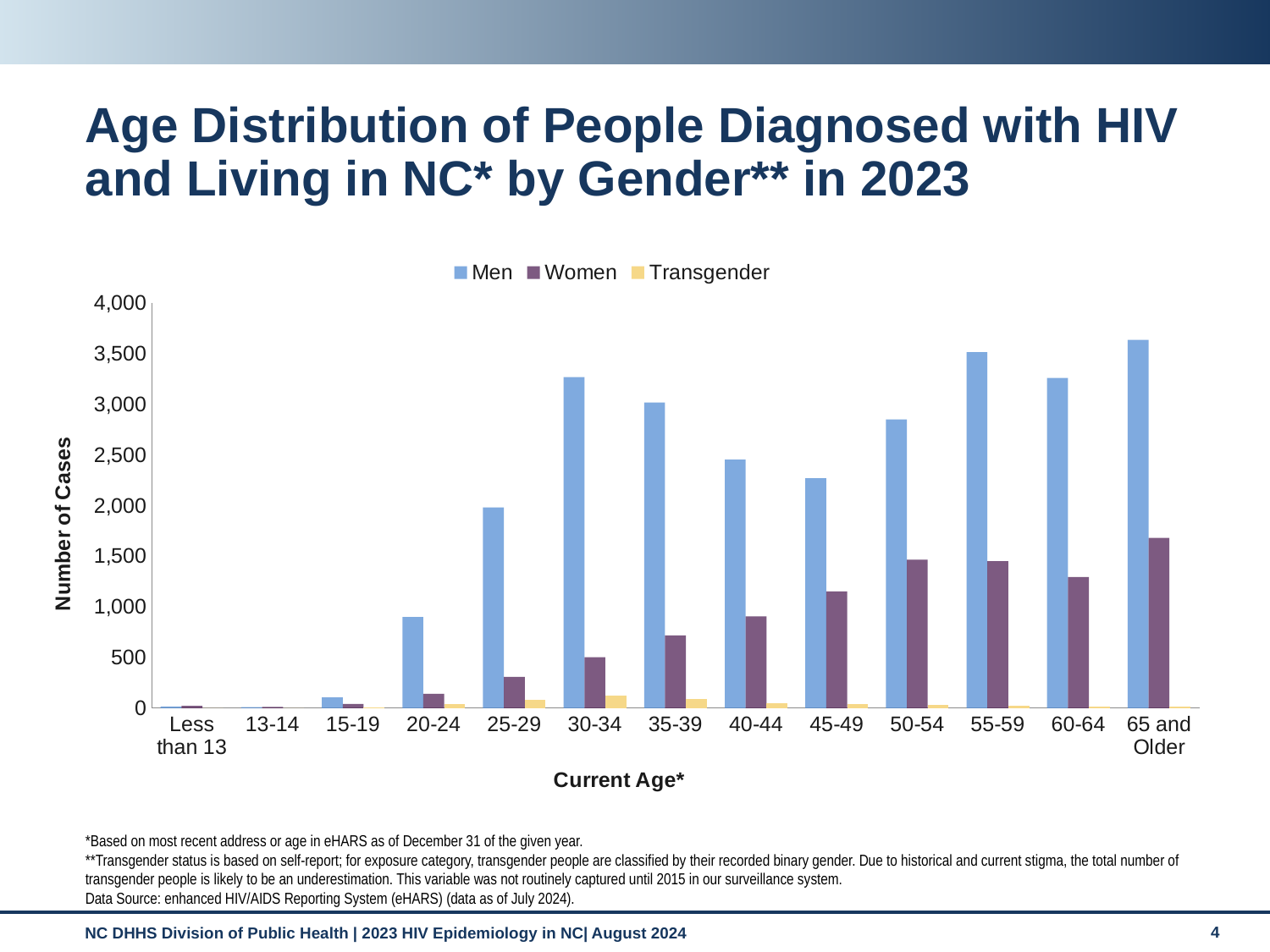
What kind of chart is shown on the slide? Bar chart Is the value for Men in the 50-54 age group greater or less than 3,000? less How many series does the legend list? 3 Which is larger: the number of cases for Men aged 30-34 or Men aged 35-39? Men aged 30-34 Which age group has the highest number of cases for Women? 65 and Older Which age group has the highest number of cases for Men? 65 and Older How many age categories are shown on the x axis? 13 Which is larger: the number of cases for Women aged 55-59 or Women aged 60-64? Women aged 55-59 What is the label of the y axis? Number of Cases Is the value for Men in the 30-34 age group greater or less than 3,000? greater Is the value for Women in the 45-49 age group greater or less than 1,000? greater